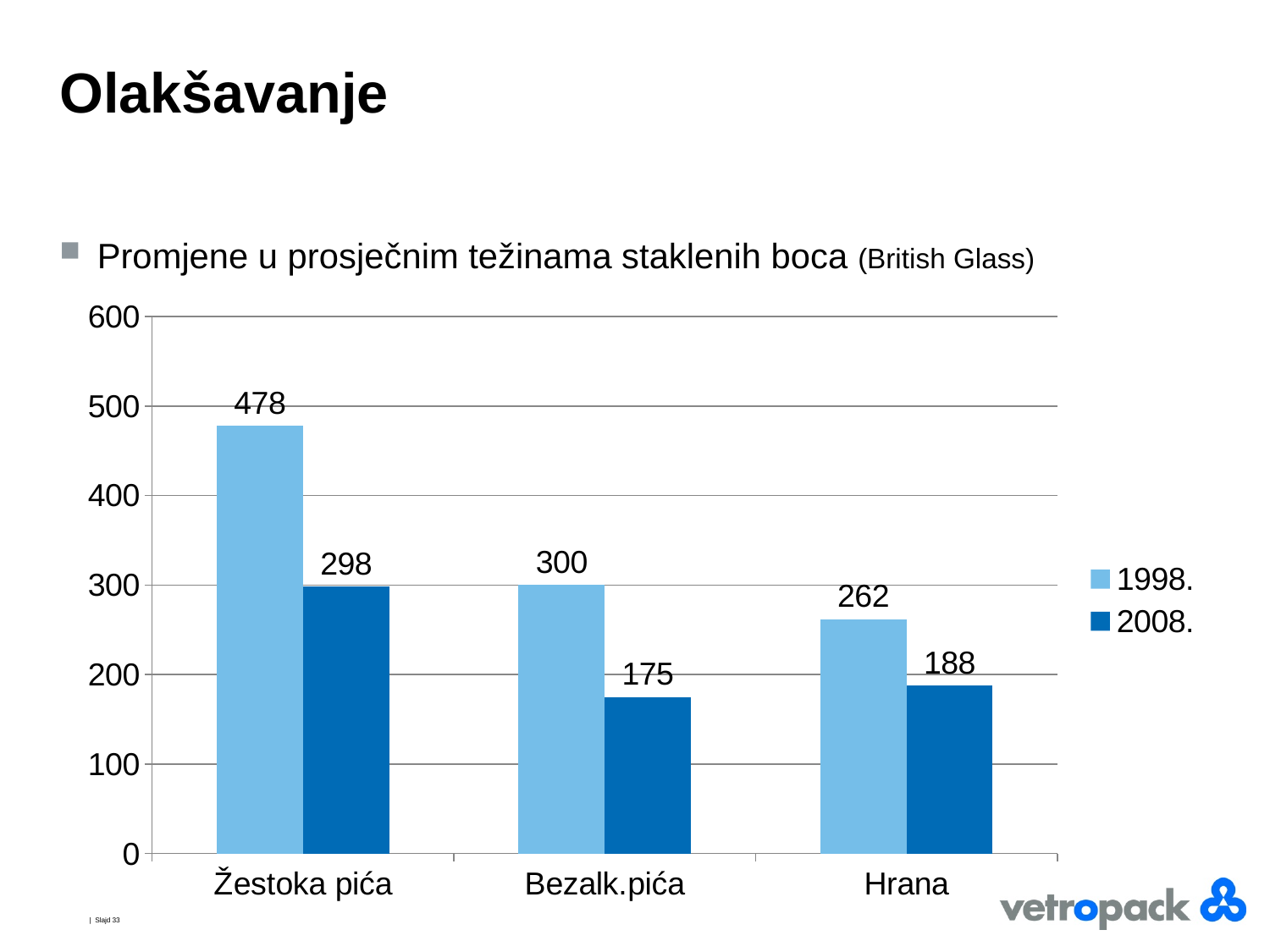
How many series does the legend list? 2 Which is larger: the 2008. value for Žestoka pića or the 2008. value for Hrana? Žestoka pića How many categories are shown on the x axis? 3 What is the value for Žestoka pića in 1998.? 478 What is the value for Hrana in 1998.? 262 Which category has the lowest value in the 2008. series? Bezalk.pića What is the value for Bezalk.pića in 2008.? 175 What kind of chart is shown on the slide? Bar chart What is the difference between the 1998. and 2008. values for Bezalk.pića? 125 Which category has the highest value in the 1998. series? Žestoka pića What is the difference between the 1998. and 2008. values for Žestoka pića? 180 What are the two series listed in the legend? 1998. and 2008.